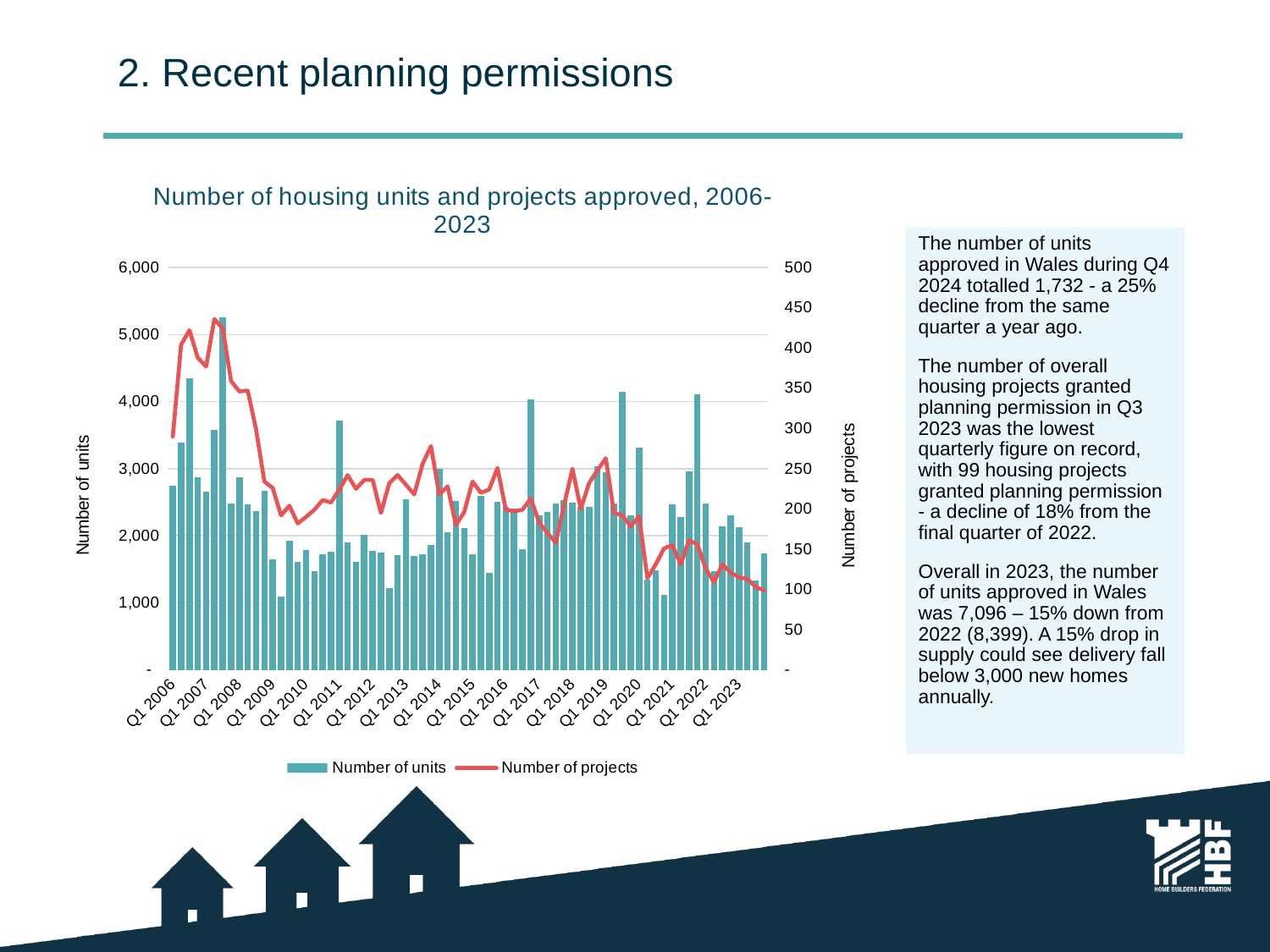
Is the Number of units for Q1 2010 greater or less than 2,000? less Is the Number of projects for Q1 2008 greater or less than 400? less What kind of chart is shown on the slide? A combined bar and line chart Does the Number of projects line rise or fall between Q1 2008 and Q1 2009? fall Is the Number of projects for Q1 2023 greater or less than 150? less What is the title of the chart? Number of housing units and projects approved, 2006-2023 How many series does the chart legend list? 2 Which has the larger Number of units, Q1 2007 or Q1 2010? Q1 2007 Which series is plotted as a line rather than bars? Number of projects